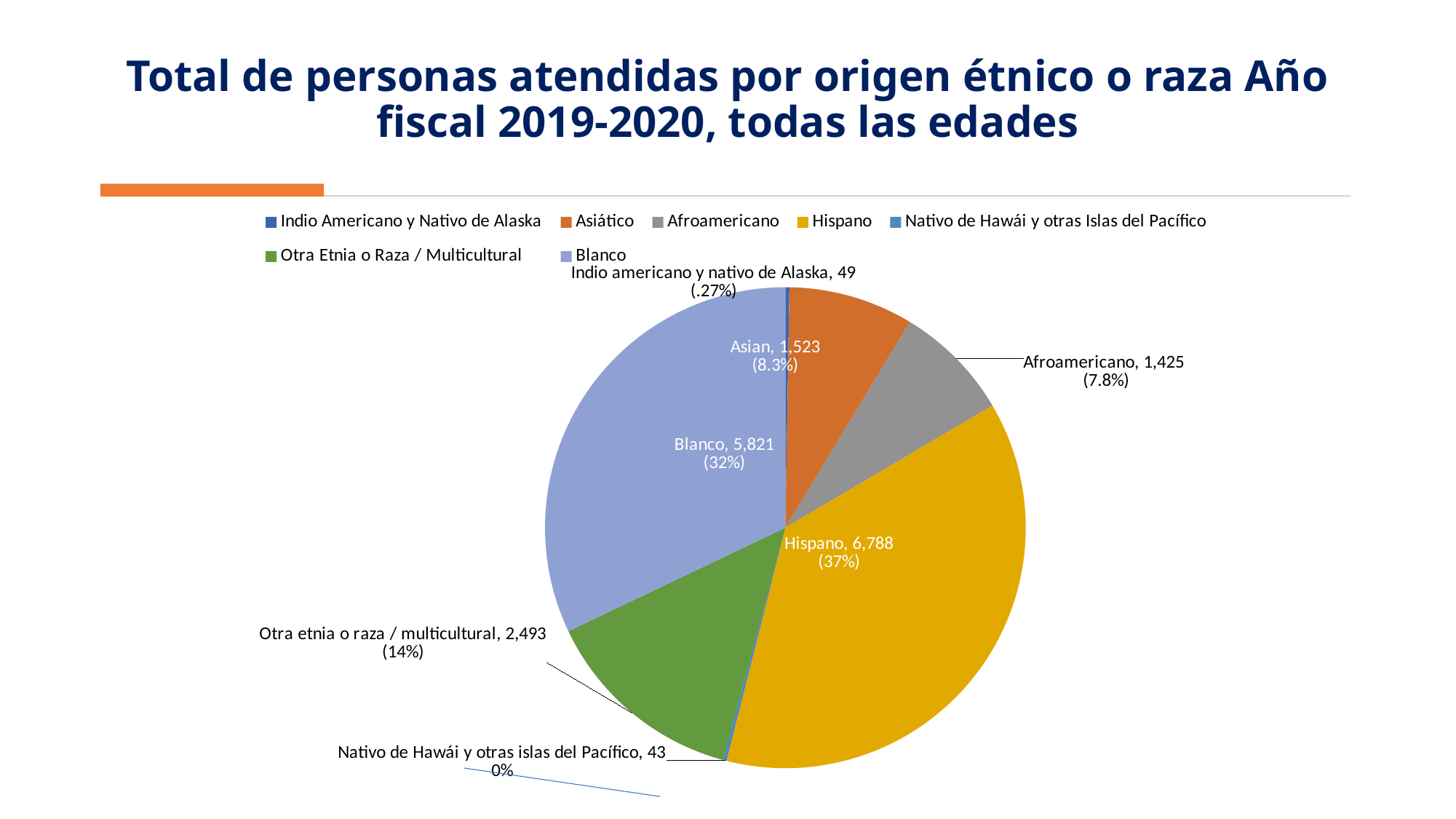
What value is shown for Afroamericano? 1,425 What value is shown for Blanco? 5,821 Which category has the largest slice of the pie? Hispano Which is larger, the value for Asian or the value for Afroamericano? Asian What share of the pie does Blanco represent? 32% How many people served are labelled for Hispano? 6,788 What kind of chart is shown on the slide? pie chart What value is shown for Nativo de Hawái y otras islas del Pacífico? 43 What share of the pie does Otra etnia o raza / multicultural represent? 14% How many categories does the legend list? 7 Which category has the smallest value in the pie chart? Nativo de Hawái y otras islas del Pacífico What is the difference between the Hispano value and the Blanco value? 967